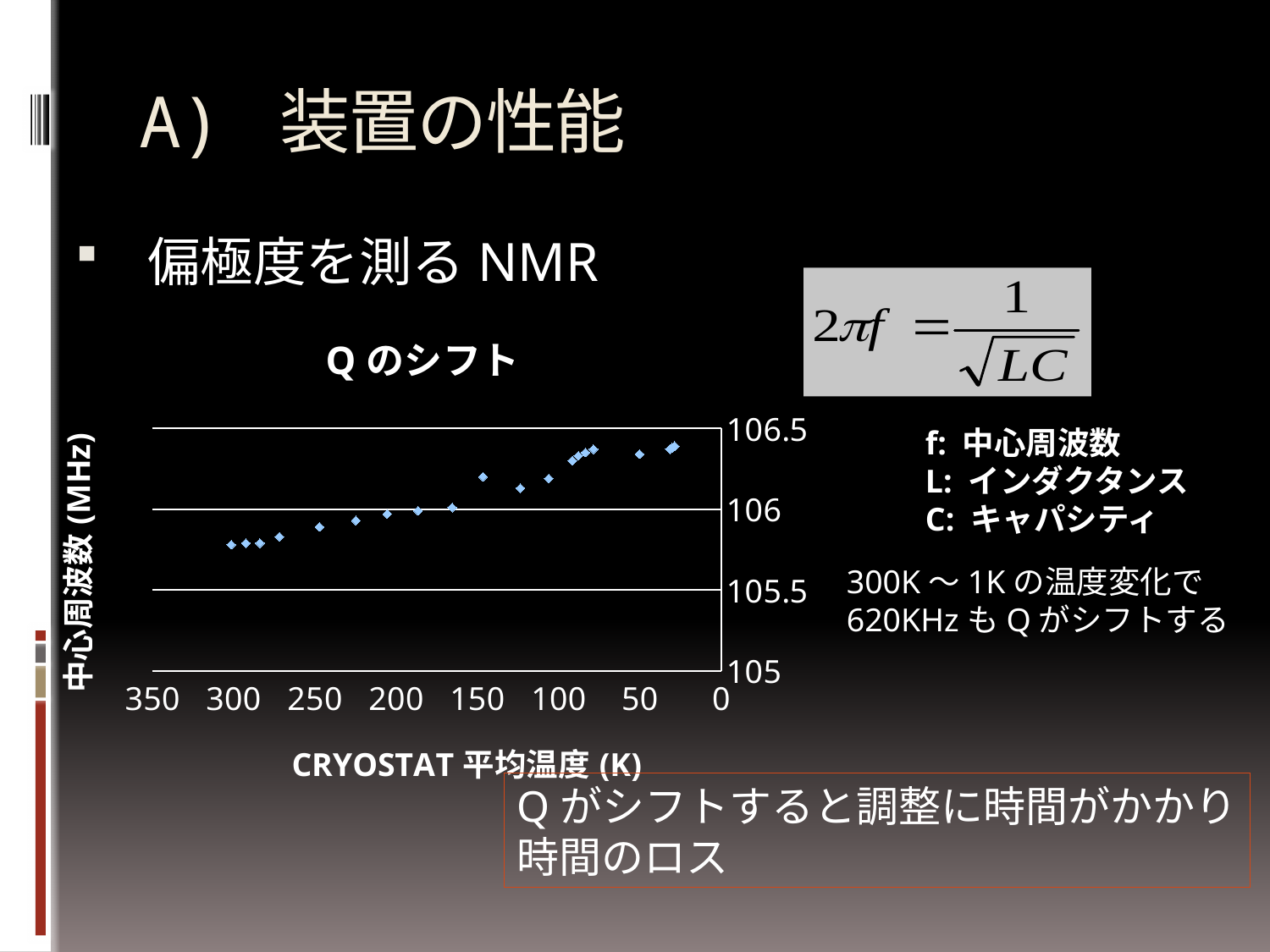
Is the center frequency at a cryostat temperature of 50 K greater or less than 106.5 MHz? less Which has the higher center frequency: the point at 300 K or the point at 50 K? 50 K What is the label of the x axis of the chart? CRYOSTAT 平均温度 (K) Is the center frequency at a cryostat temperature of 150 K greater or less than 106 MHz? greater What is the title of the chart? Qのシフト Is the center frequency at a cryostat temperature of 300 K greater or less than 106 MHz? less What kind of chart is shown on the slide? scatter chart What is the highest value shown on the y axis of the chart? 106.5 Moving from left to right along the x axis (from 350 K toward 0 K), do the plotted center frequencies rise or fall? rise